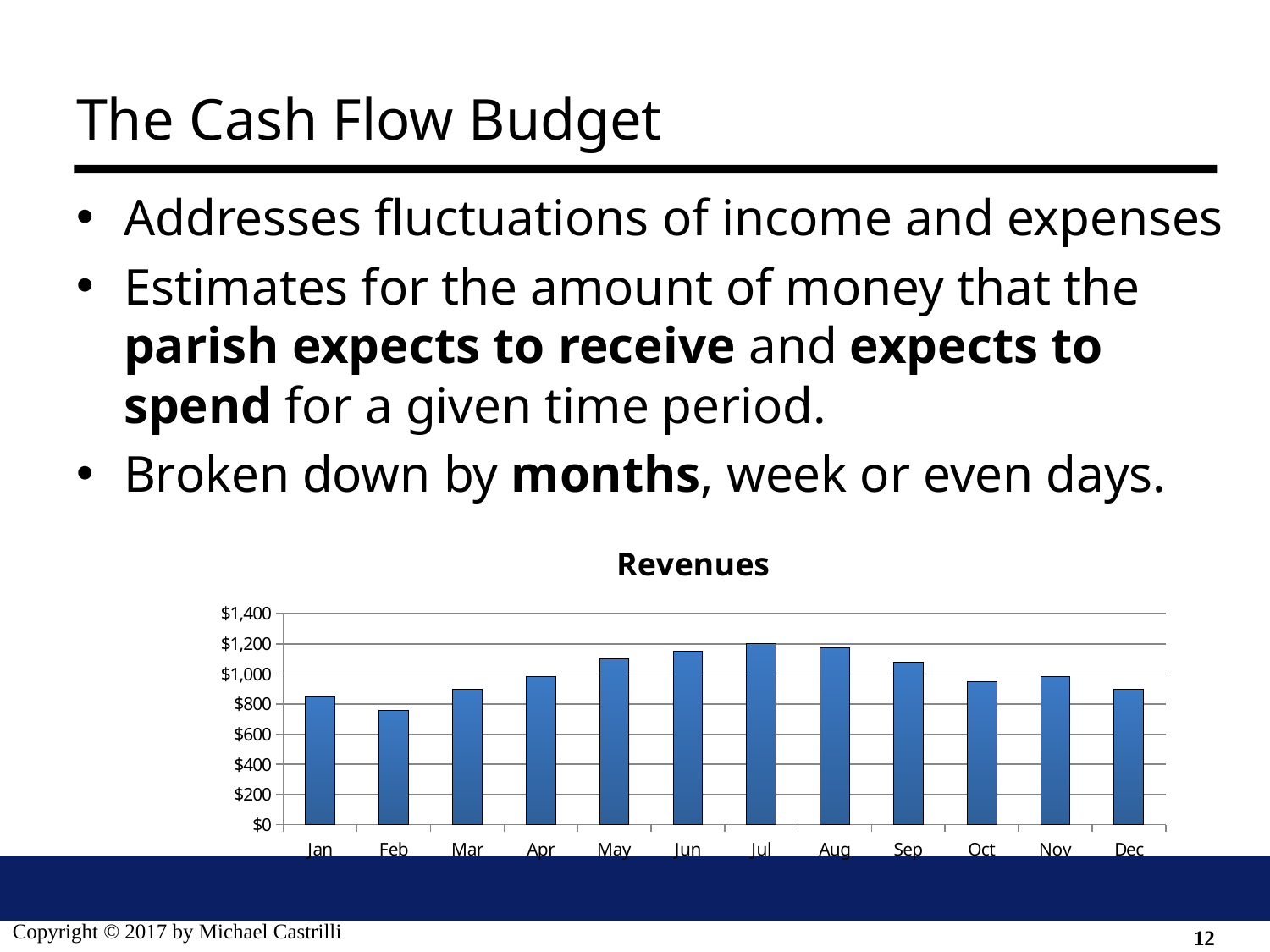
Is the revenue for Feb greater or less than $800? less What kind of chart is shown on the slide? bar chart Is the revenue for Jun greater or less than $1,200? less How many months are plotted on the x axis of the Revenues chart? 12 Which month has the lowest revenue in the chart? Feb Which month has the higher revenue, Jul or Feb? Jul Is the revenue for May greater or less than $1,000? greater What is the title of the chart? Revenues Do revenues rise or fall from Feb to Jul? rise Which month has the higher revenue, Sep or Dec? Sep